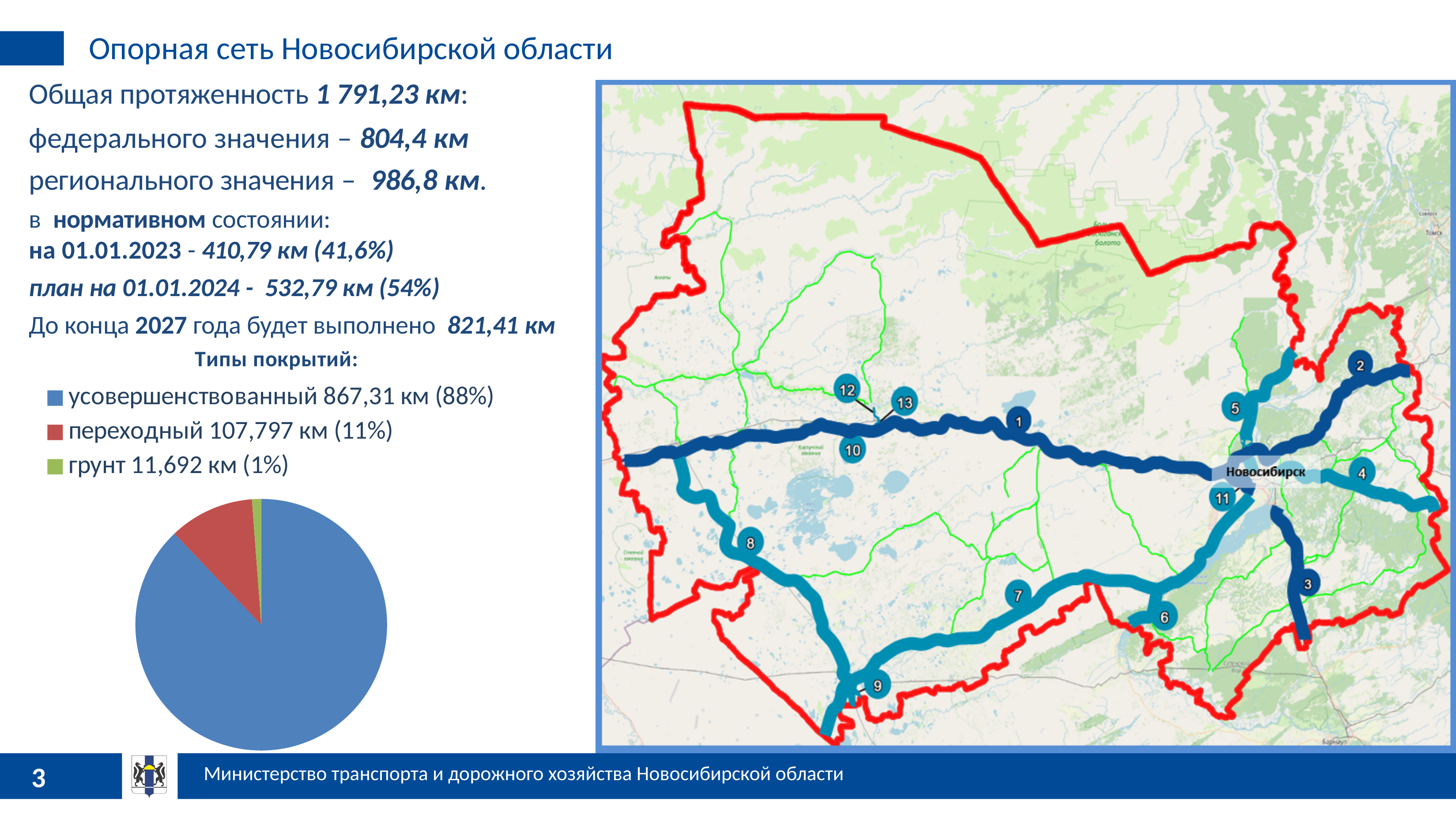
What colour is the "переходный" slice in the "Типы покрытий" pie chart? red What is the length shown for "переходный" in the "Типы покрытий" chart? 107,797 км What kind of chart is shown under "Типы покрытий"? pie chart Which surface type has the largest slice in the "Типы покрытий" pie chart? усовершенствованный How many slices does the "Типы покрытий" pie chart have? 3 What share of the "Типы покрытий" pie does "переходный" take? 11% In the "Типы покрытий" chart, which is larger: "переходный" or "грунт"? переходный What share of the "Типы покрытий" pie does "грунт" take? 1% What share of the "Типы покрытий" pie does "усовершенствованный" take? 88% What is the length shown for "усовершенствованный" in the "Типы покрытий" chart? 867,31 км Which surface type has the smallest slice in the "Типы покрытий" pie chart? грунт What is the length shown for "грунт" in the "Типы покрытий" chart? 11,692 км